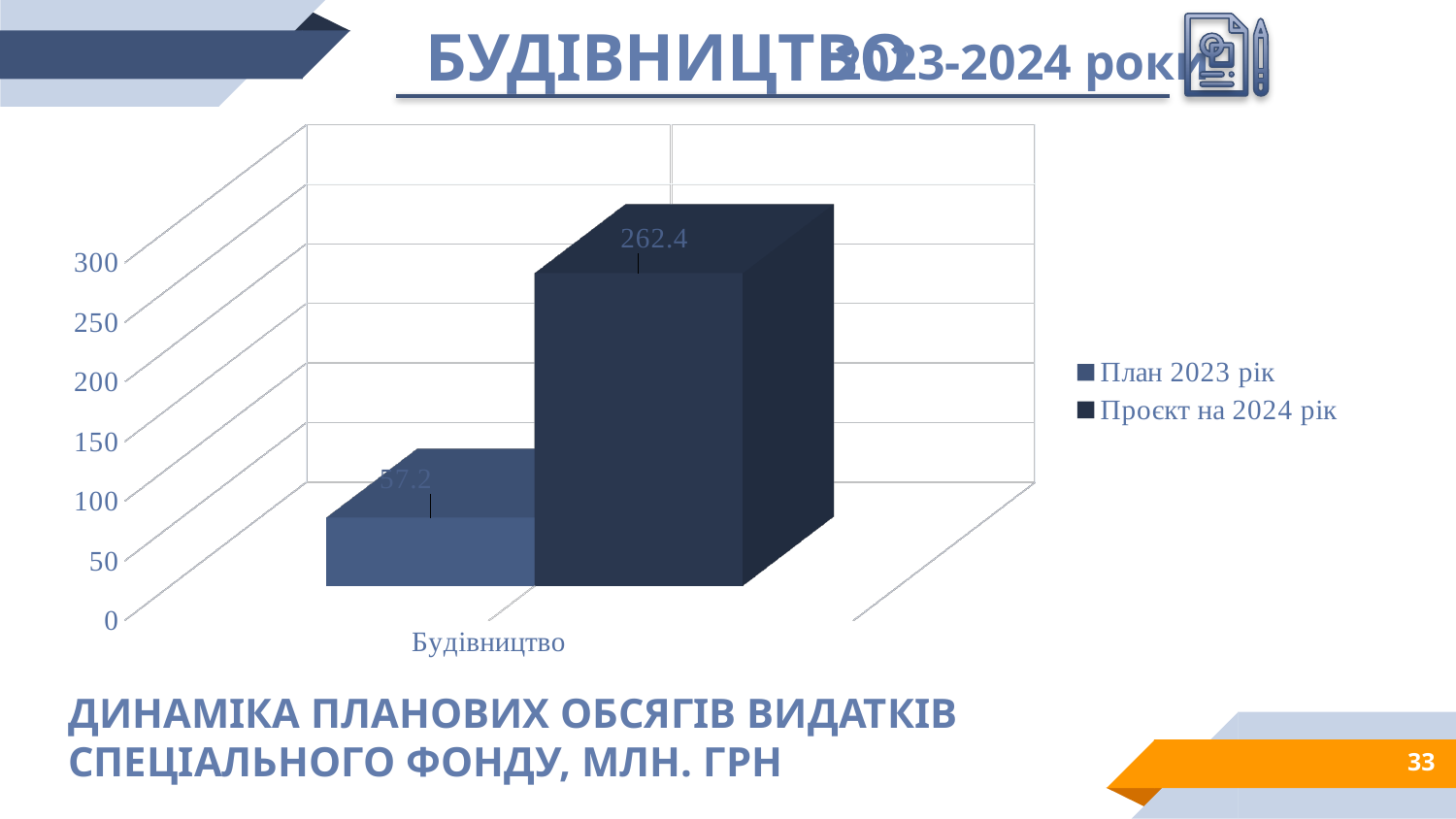
What is the value for "Проєкт на 2024 рік" for Будівництво? 262.4 What kind of chart is shown on the slide? bar chart How many series does the legend list? 2 Is the value for "Проєкт на 2024 рік" greater or less than 250? greater What is the name of the category shown on the x axis? Будівництво Which series has the lowest value in the chart? План 2023 рік What is the difference between the "Проєкт на 2024 рік" value and the "План 2023 рік" value for Будівництво? 205.2 Is the value for "План 2023 рік" greater or less than 100? less What is the value for "План 2023 рік" for Будівництво? 57.2 Which series has the higher value for Будівництво, "План 2023 рік" or "Проєкт на 2024 рік"? Проєкт на 2024 рік What is the highest value labelled on the vertical axis of the chart? 300 How many categories are shown on the x axis of the chart? 1